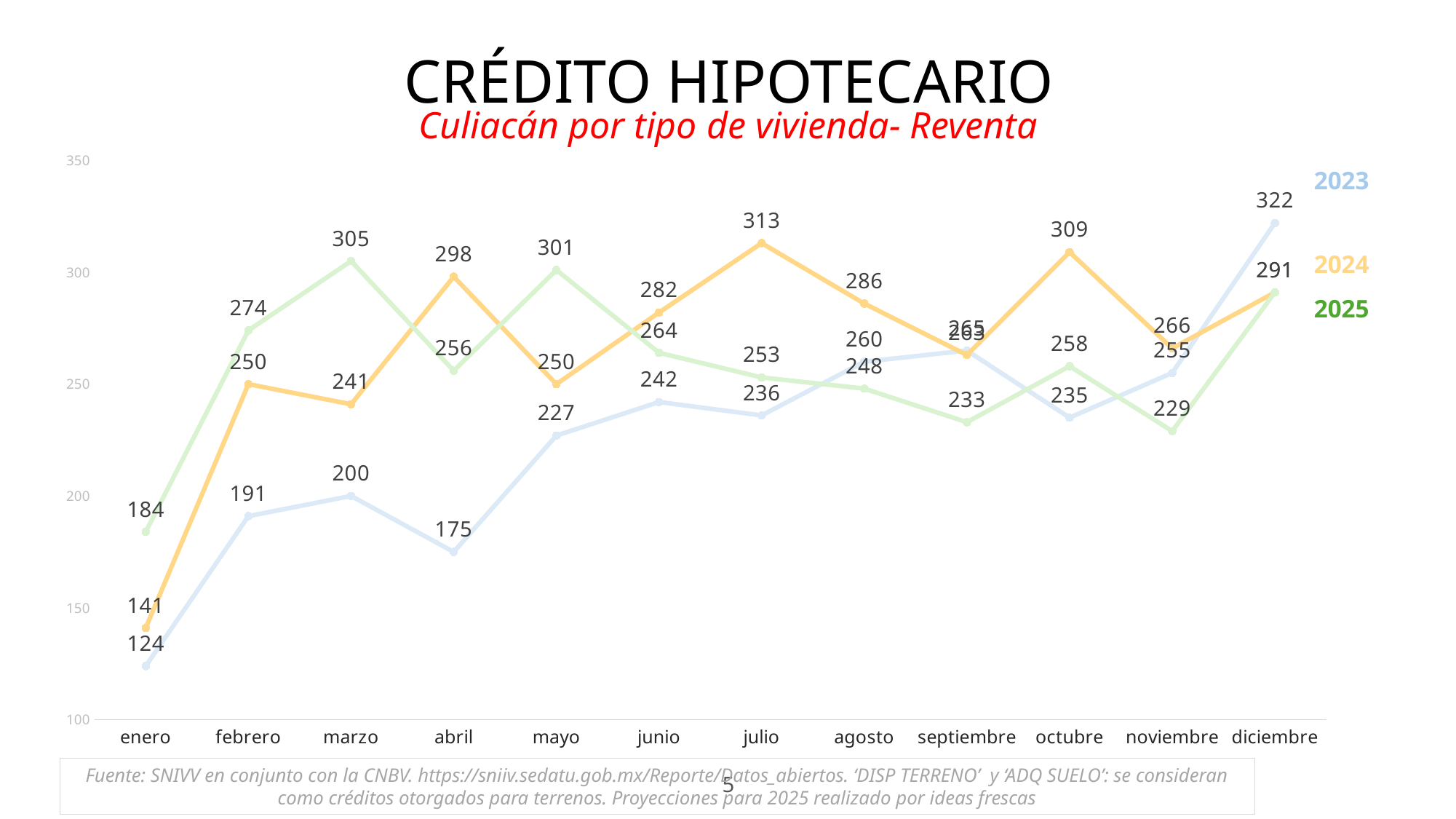
In which month does the 2024 series reach its highest value? julio In which month does the 2023 series have its lowest value? enero What kind of chart is shown on the slide? line chart Is the value for 2023 in abril greater or less than 200? less How many series does the legend list? 3 How many months are shown on the x axis? 12 What is the difference between the 2024 and 2023 values in abril? 123 In mayo, which series has the larger value, 2024 or 2025? 2025 What is the value for 2025 in marzo? 305 What is the value for 2024 in julio? 313 In which month does the 2023 series reach its highest value? diciembre What is the value for 2023 in enero? 124